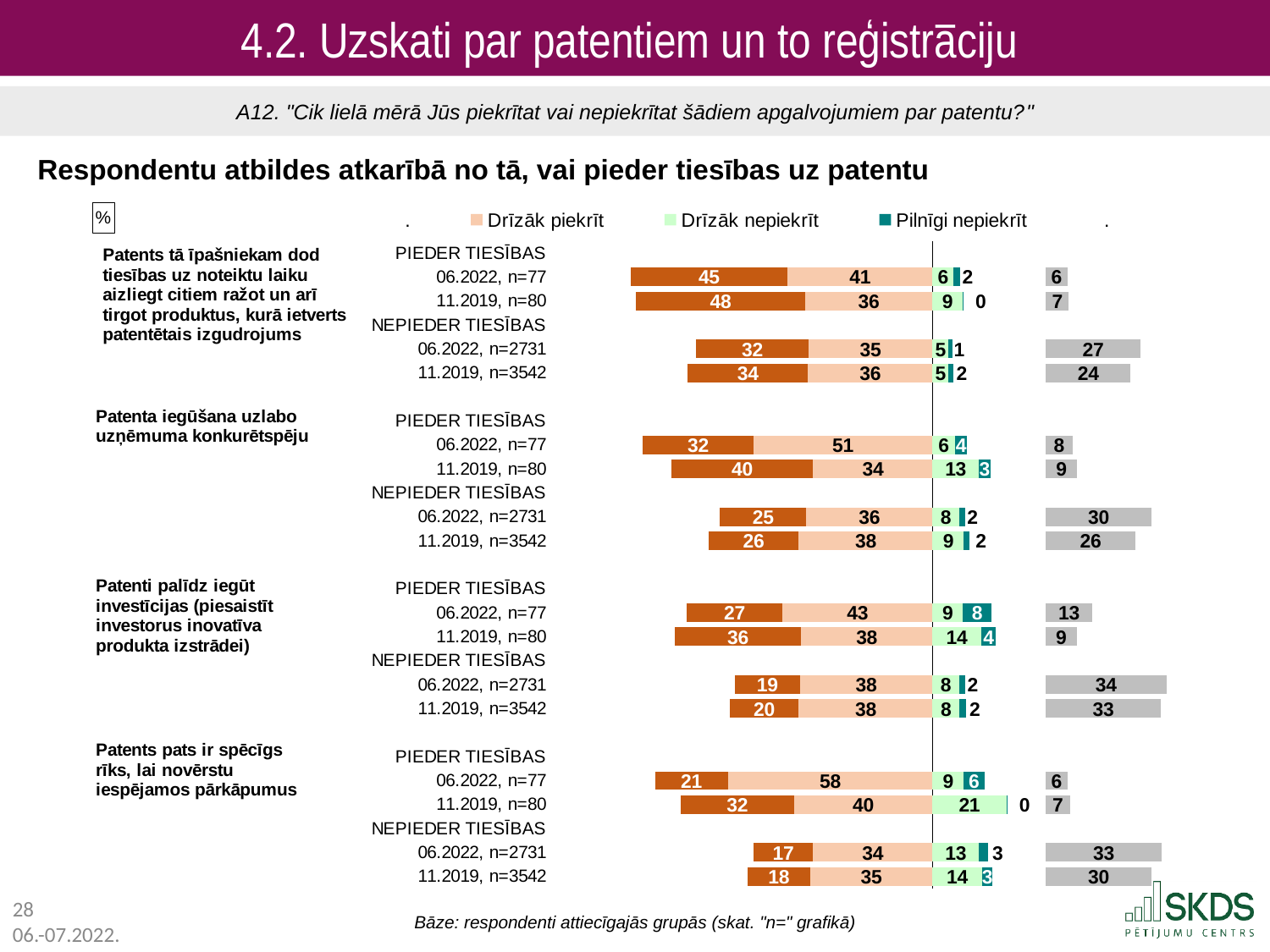
For "Patenti palīdz iegūt investīcijas" among NEPIEDER TIESĪBAS, which is larger: the "Drīzāk nepiekrīt" value for 06.2022 (n=2731) or the "Pilnīgi nepiekrīt" value for 06.2022 (n=2731)? Drīzāk nepiekrīt How many statements (question items) are shown in the chart? 4 What is the "Drīzāk nepiekrīt" value for "Patents pats ir spēcīgs rīks, lai novērstu iespējamos pārkāpumus" among PIEDER TIESĪBAS, 11.2019, n=80? 21 What is the combined "Drīzāk nepiekrīt" and "Pilnīgi nepiekrīt" value for "Patents pats ir spēcīgs rīks" among NEPIEDER TIESĪBAS, 06.2022, n=2731? 16 For "Patenta iegūšana uzlabo uzņēmuma konkurētspēju", is the "Drīzāk piekrīt" value for PIEDER TIESĪBAS 06.2022 (n=77) larger or smaller than for 11.2019 (n=80)? larger What is the "Pilnīgi nepiekrīt" value for "Patenti palīdz iegūt investīcijas" among PIEDER TIESĪBAS, 06.2022, n=77? 8 Which legend entry is shown in dark green? Pilnīgi nepiekrīt Across all bars, which row has the highest "Drīzāk piekrīt" value? Patents pats ir spēcīgs rīks, PIEDER TIESĪBAS, 06.2022, n=77 What is the "Drīzāk piekrīt" value for "Patenta iegūšana uzlabo uzņēmuma konkurētspēju" among NEPIEDER TIESĪBAS, 11.2019, n=3542? 38 What kind of chart is shown on the slide? stacked bar chart What is the "Drīzāk piekrīt" value for "Patents pats ir spēcīgs rīks, lai novērstu iespējamos pārkāpumus" among PIEDER TIESĪBAS, 06.2022, n=77? 58 For "Patents tā īpašniekam dod tiesības..." among PIEDER TIESĪBAS, what is the difference between the "Drīzāk piekrīt" values for 06.2022 (n=77) and 11.2019 (n=80)? 5